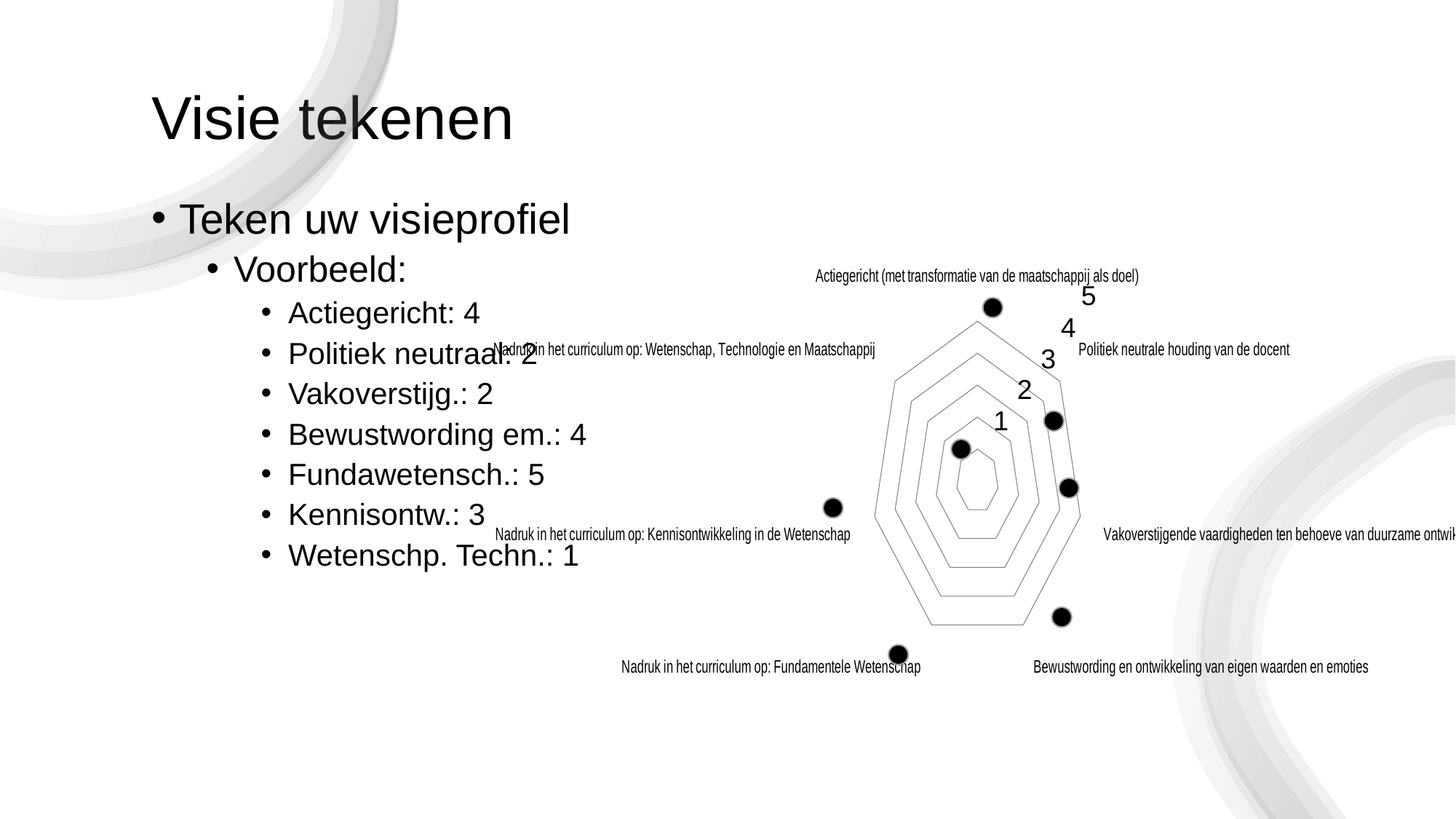
What kind of chart is shown on the slide? radar chart What is the lowest scale value labelled on the radar chart? 1 How many concentric rings (scale levels) does the radar chart have? 5 Which axis label appears at the bottom right of the radar chart? Bewustwording en ontwikkeling van eigen waarden en emoties How many axes (categories) does the radar chart have? 7 Which axis label appears at the top of the radar chart? Actiegericht (met transformatie van de maatschappij als doel) What is the highest scale value shown on the radar chart? 5 Which axis label appears at the bottom left of the radar chart? Nadruk in het curriculum op: Fundamentele Wetenschap